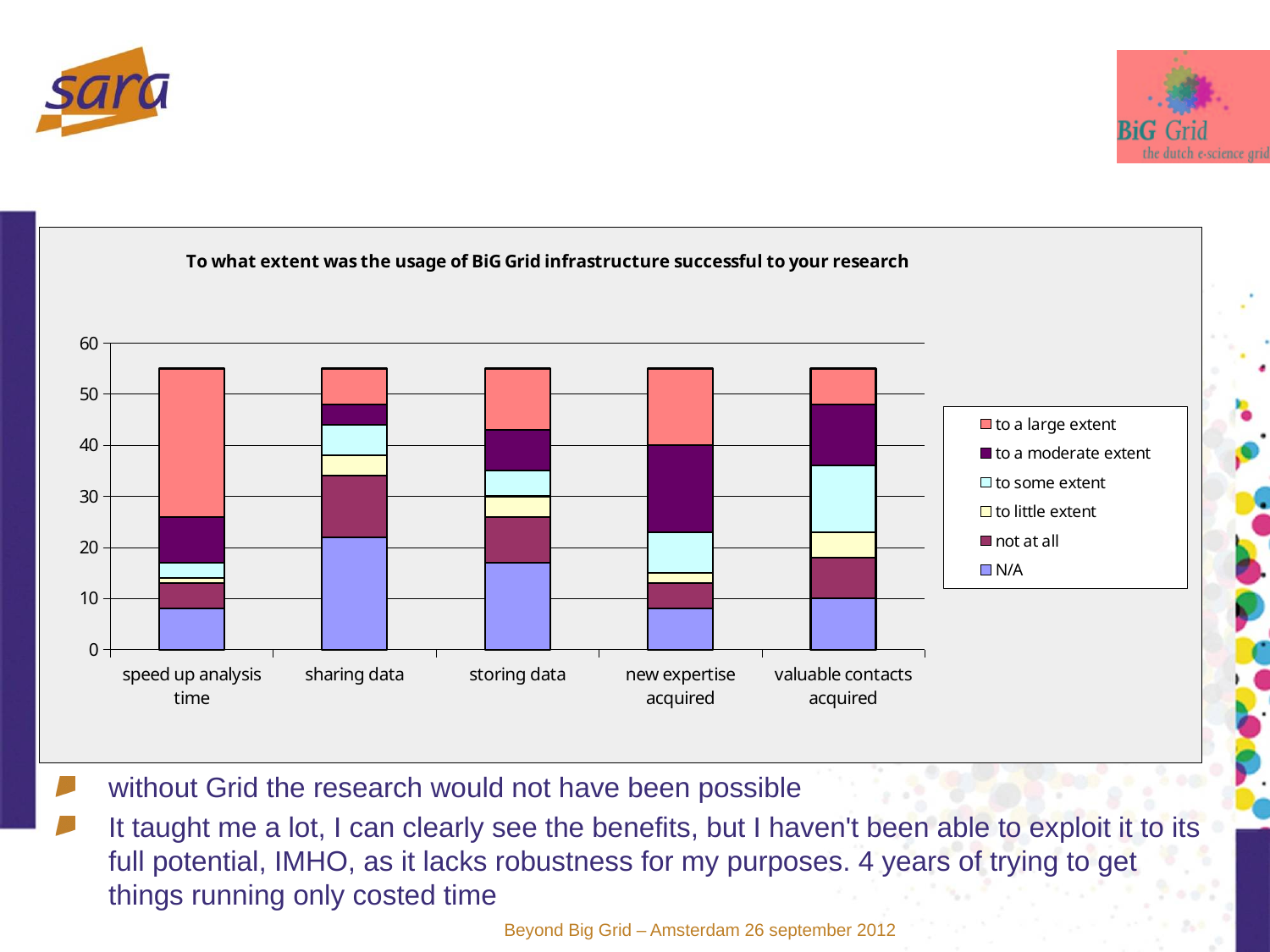
Which category has the largest 'N/A' segment? sharing data Which category has the largest 'to a large extent' segment? speed up analysis time What kind of chart is shown on the slide? stacked bar chart Which is larger: the 'N/A' segment for 'sharing data' or for 'new expertise acquired'? sharing data Is the 'N/A' segment for 'storing data' greater or less than 10? greater How many categories are shown on the x axis of the chart? 5 What is the title of the chart? To what extent was the usage of BiG Grid infrastructure successful to your research Which legend entry is listed last in the chart's legend? N/A How many series does the chart's legend list? 6 Is the total height of the stacked bar for 'speed up analysis time' greater or less than 50? greater Is the 'to a large extent' segment for 'speed up analysis time' greater or less than 20? greater